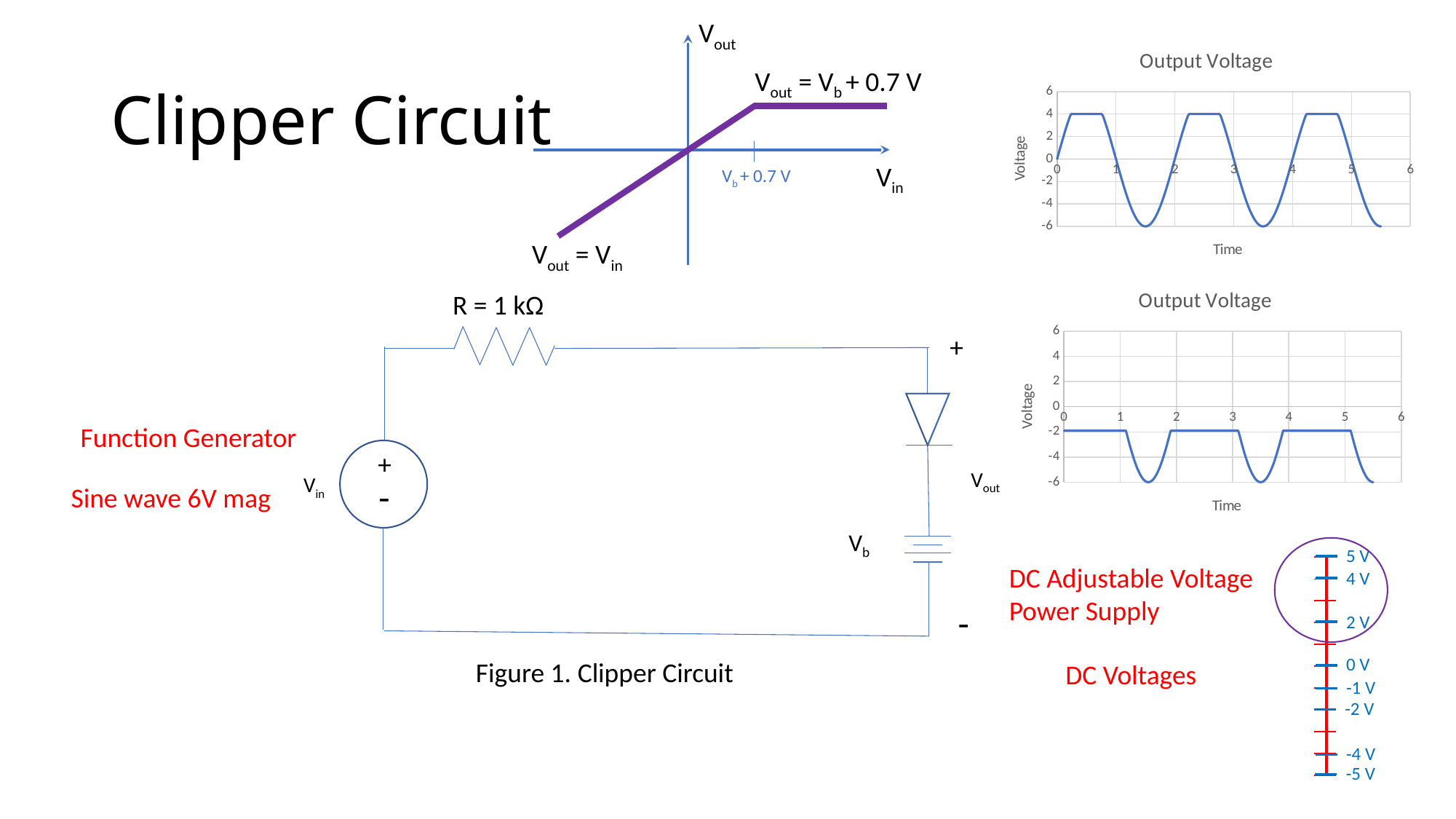
In the bottom 'Output Voltage' chart, is the flat clipped level greater or less than 0? less What kind of chart is the top 'Output Voltage' chart? line chart What is the label on the horizontal axis of the top 'Output Voltage' chart? Time In the top 'Output Voltage' chart, what is the highest voltage the waveform reaches (the flat clipped level)? 4 Which chart has the higher peak voltage, the top 'Output Voltage' chart or the bottom 'Output Voltage' chart? the top chart How many downward dips does the waveform in the bottom 'Output Voltage' chart show? 3 In the top 'Output Voltage' chart, what is the lowest voltage the waveform reaches? -6 How many flat clipped peaks does the waveform in the top 'Output Voltage' chart show? 3 What is the label on the vertical axis of the bottom 'Output Voltage' chart? Voltage In the top 'Output Voltage' chart, is the peak voltage greater or less than 2? greater In the bottom 'Output Voltage' chart, what is the lowest voltage the waveform reaches? -6